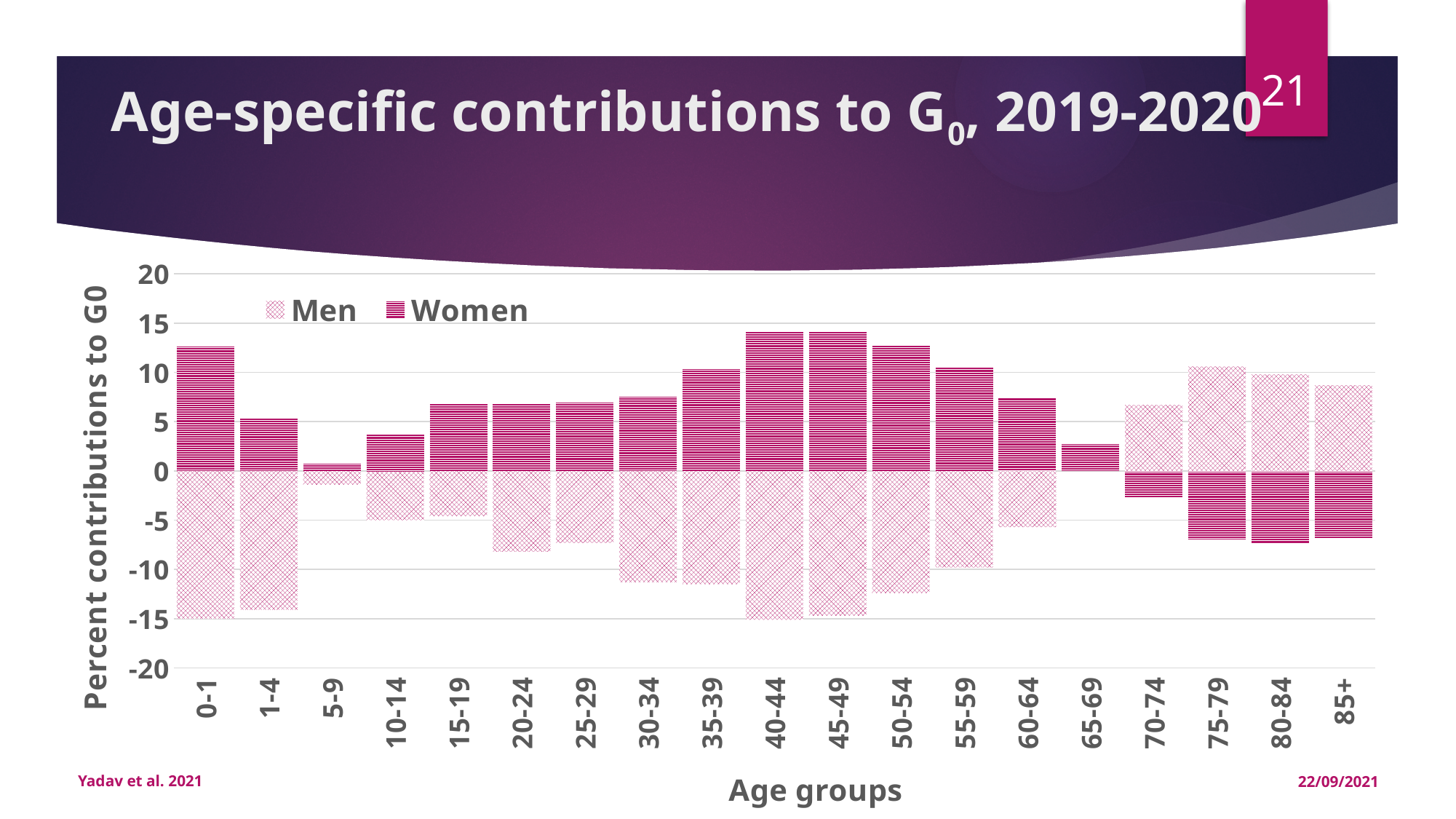
Is the Women value for the 0-1 age group greater or less than 10? greater Do the Women values rise or fall from the 50-54 age group to the 65-69 age group? fall How many age groups are shown on the x axis? 19 Is the Men value for the 0-1 age group greater or less than -10? less What is the title of the y axis? Percent contributions to G0 Is the Men value for the 30-34 age group greater or less than -10? less What are the two series named in the legend? Men and Women What kind of chart is shown on the slide? bar chart How many series does the legend list? 2 Which is larger, the Women value for 40-44 or the Women value for 5-9? 40-44